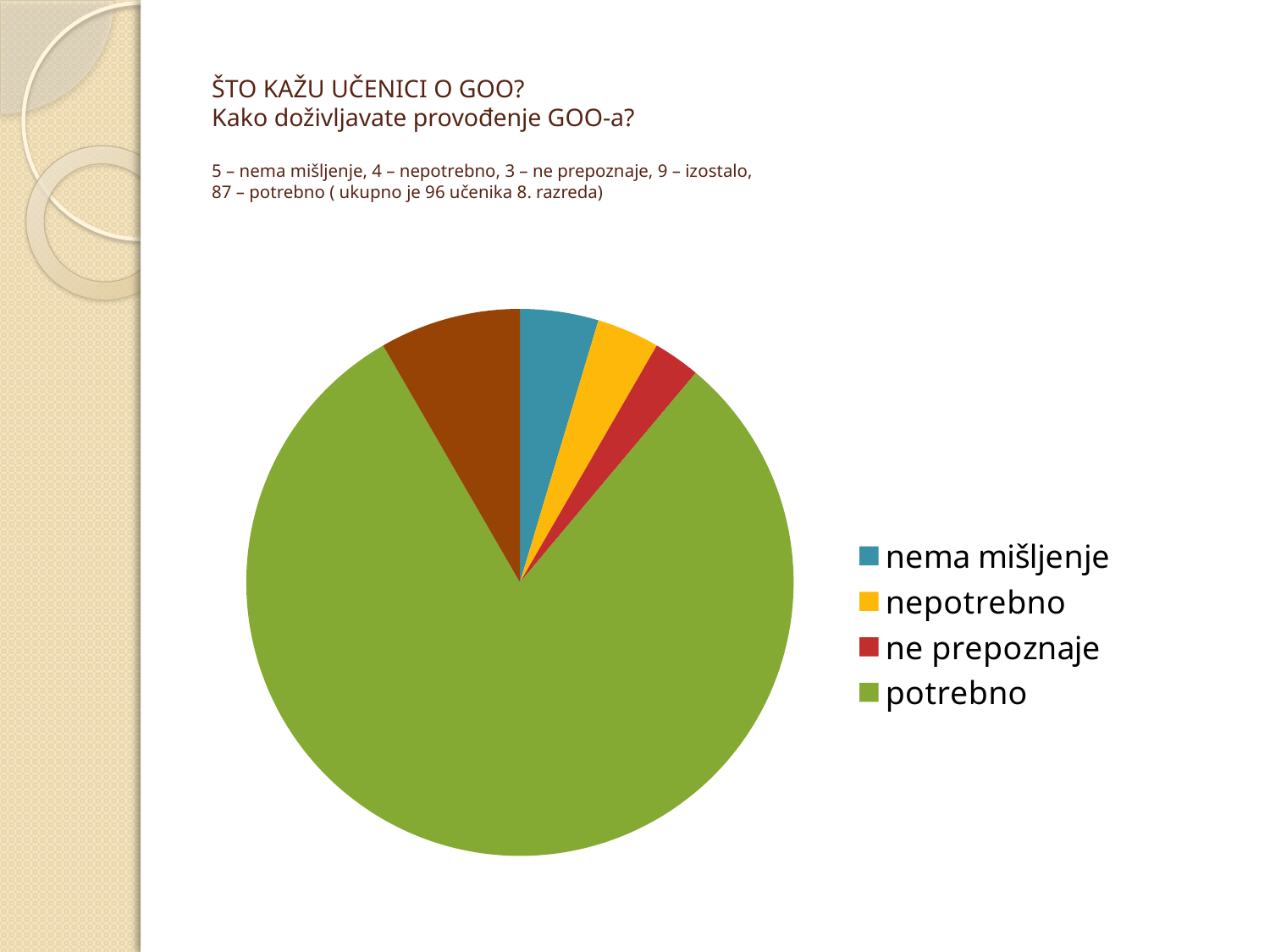
Which category has the largest slice in the pie chart? potrebno What colour is the 'potrebno' slice in the pie chart? green According to the slide, how many students answered 'nepotrebno'? 4 According to the slide, how many students answered 'ne prepoznaje'? 3 Which legend category has the smallest slice in the pie chart? ne prepoznaje How many slices does the pie chart have? 5 According to the slide, how many students answered 'nema mišljenje'? 5 What is the difference between the number of students who answered 'potrebno' and those who answered 'nema mišljenje'? 82 According to the slide, how many students answered 'potrebno'? 87 How many entries does the legend of the pie chart list? 4 Which is larger in the pie chart, 'potrebno' or 'nema mišljenje'? potrebno What kind of chart is shown on the slide? pie chart